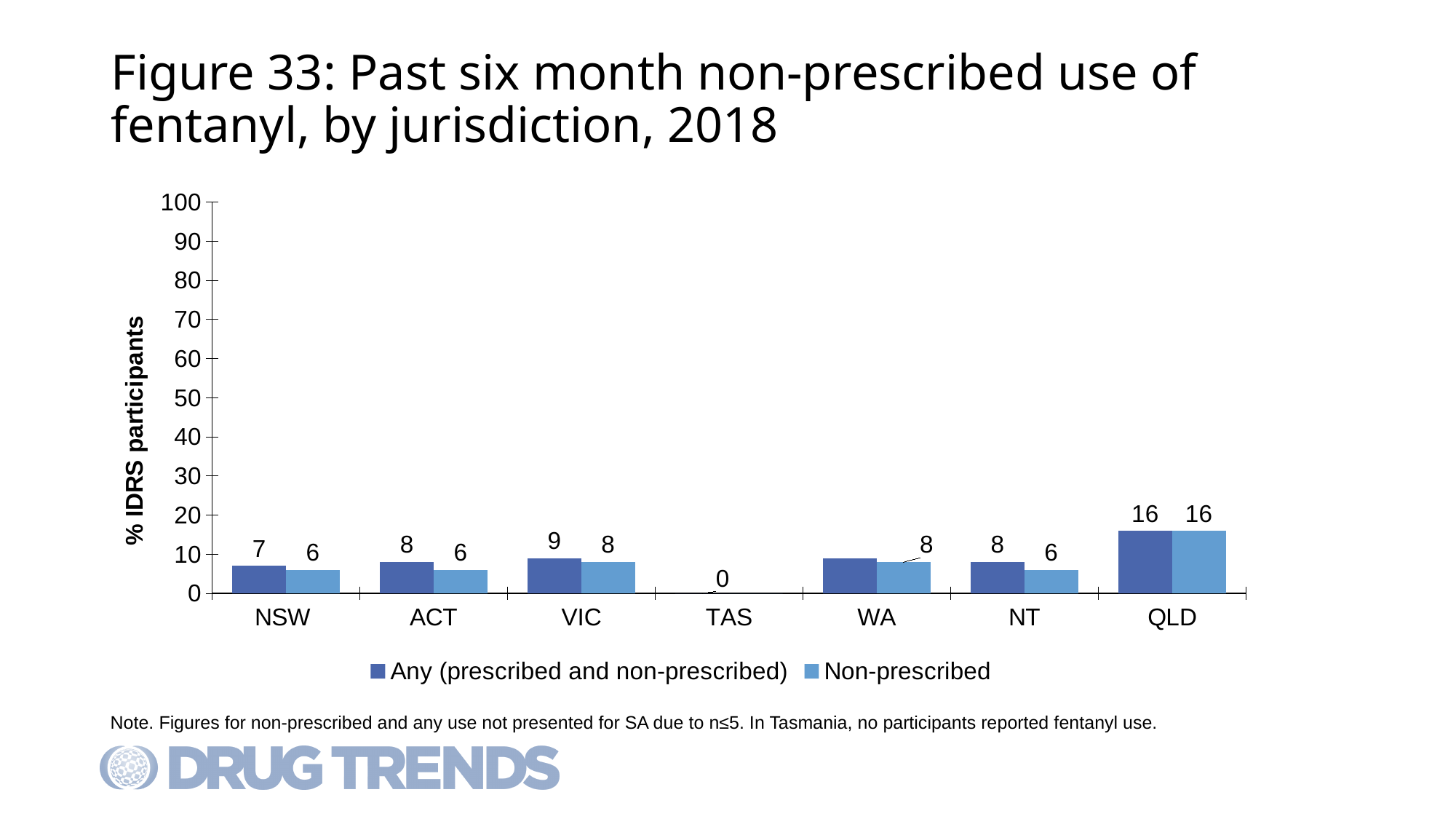
What is the difference between the Any (prescribed and non-prescribed) values for QLD and NSW? 9 How many series does the legend list? 2 What is the value for Non-prescribed use in QLD? 16 What is the value for Non-prescribed use in NT? 6 Which jurisdiction has the highest value for Any (prescribed and non-prescribed) use? QLD Which jurisdiction has the lowest value shown on the chart? TAS What is the label on the y axis? % IDRS participants How many jurisdictions are shown on the x axis? 7 Which is larger: the Non-prescribed value for VIC or the Non-prescribed value for ACT? VIC What type of chart is shown on the slide? bar chart What is the value for Any (prescribed and non-prescribed) use in VIC? 9 What is the value for Any (prescribed and non-prescribed) use in NSW? 7